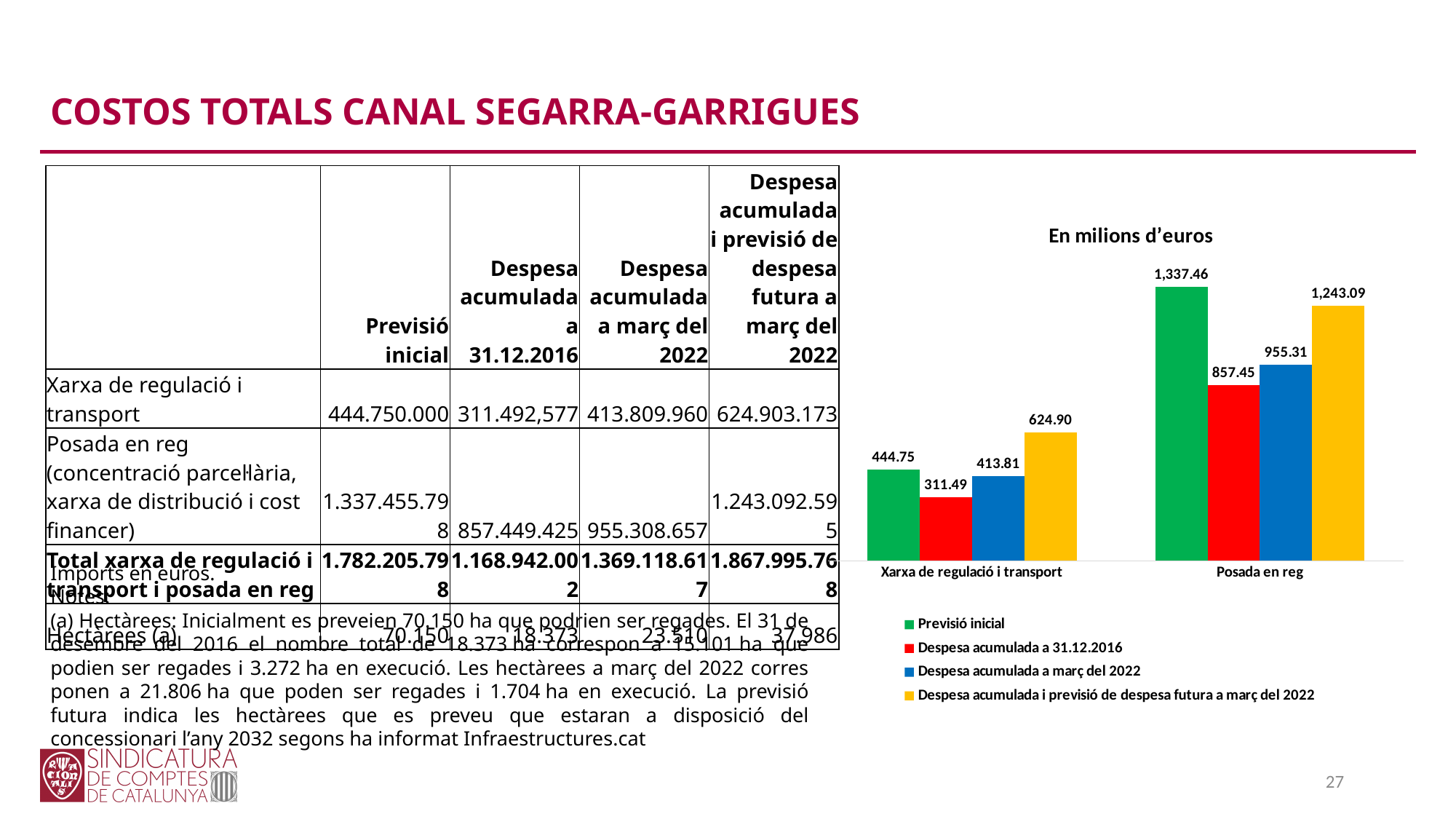
What is the value of Previsió inicial for Xarxa de regulació i transport? 444.75 What is the value of Despesa acumulada a març del 2022 for Xarxa de regulació i transport? 413.81 What type of chart is shown on the slide? bar chart For Posada en reg, which is larger: Despesa acumulada a març del 2022 or Despesa acumulada i previsió de despesa futura a març del 2022? Despesa acumulada i previsió de despesa futura a març del 2022 How many series does the chart legend list? 4 What is the value of Despesa acumulada i previsió de despesa futura a març del 2022 for Posada en reg? 1,243.09 What unit does the chart title say the values are in? En milions d'euros Which series has the highest value for Posada en reg? Previsió inicial How many categories are shown on the x axis of the chart? 2 Which series has the lowest value for Xarxa de regulació i transport? Despesa acumulada a 31.12.2016 What is the difference between Previsió inicial and Despesa acumulada a 31.12.2016 for Xarxa de regulació i transport? 133.26 What is the value of Despesa acumulada a 31.12.2016 for Posada en reg? 857.45